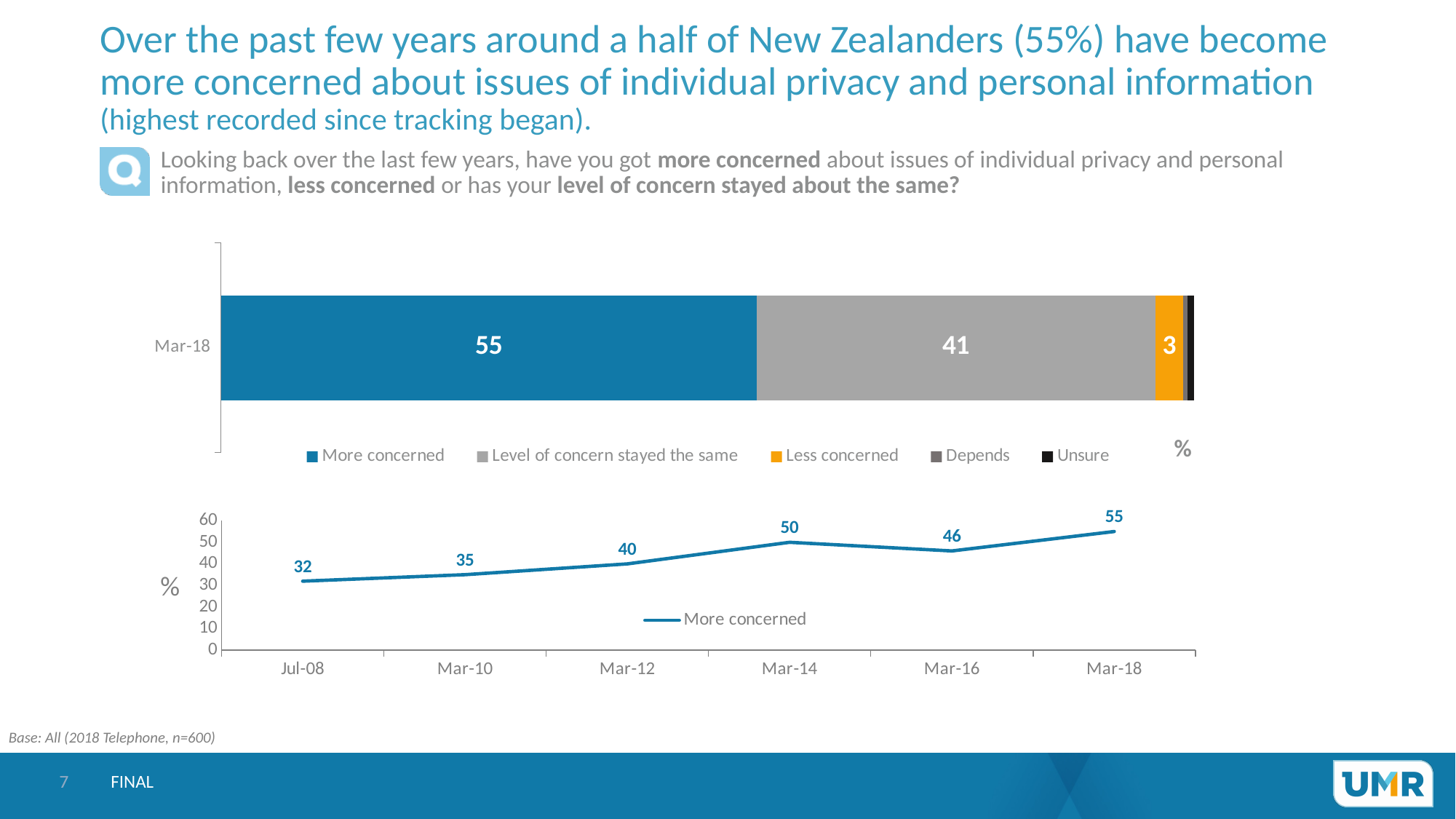
In the top stacked bar chart, what is the value for 'More concerned' in Mar-18? 55 In the bottom line chart, what is the value for Mar-14? 50 In the top stacked bar chart, what is the difference between 'More concerned' and 'Level of concern stayed the same'? 14 In the top stacked bar chart, how many series does the legend list? 5 In the top stacked bar chart, what is the value for 'Less concerned' in Mar-18? 3 In the bottom line chart, is the value for Mar-16 larger or smaller than the value for Mar-14? smaller In the bottom line chart, what is the difference between the Mar-18 and Jul-08 values? 23 In the top stacked bar chart, which series has the largest segment? More concerned In the bottom line chart, which time point has the lowest value? Jul-08 In the top stacked bar chart, what is the value for 'Level of concern stayed the same' in Mar-18? 41 In the bottom line chart, what is the value for Jul-08? 32 In the bottom line chart, how many data points are plotted? 6